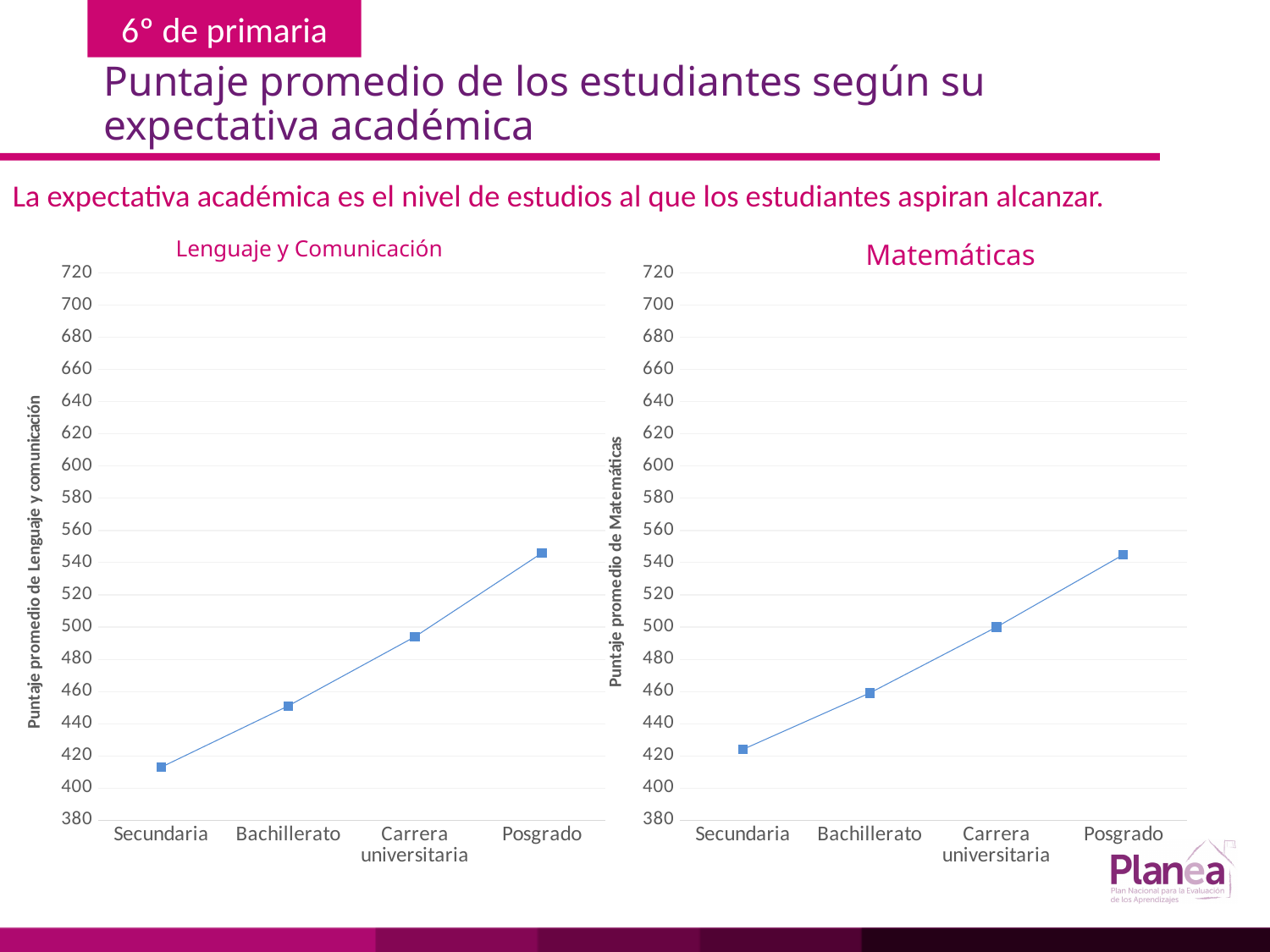
In the Matemáticas chart, which category has the lowest average score? Secundaria In the Lenguaje y Comunicación chart, is the value for Secundaria greater or less than 420? less In the Matemáticas chart, which category has the highest average score? Posgrado In the Lenguaje y Comunicación chart, which category has the lowest average score? Secundaria In the Matemáticas chart, is the value for Bachillerato greater or less than 440? greater In the Matemáticas chart, do the values rise or fall from Secundaria to Posgrado? rise In the Matemáticas chart, is the value for Posgrado greater or less than 560? less What kind of chart is the Matemáticas chart? line chart In the Lenguaje y Comunicación chart, which is larger, the value for Bachillerato or the value for Carrera universitaria? Carrera universitaria In the Lenguaje y Comunicación chart, which category has the highest average score? Posgrado How many categories are shown on the x axis of the Lenguaje y Comunicación chart? 4